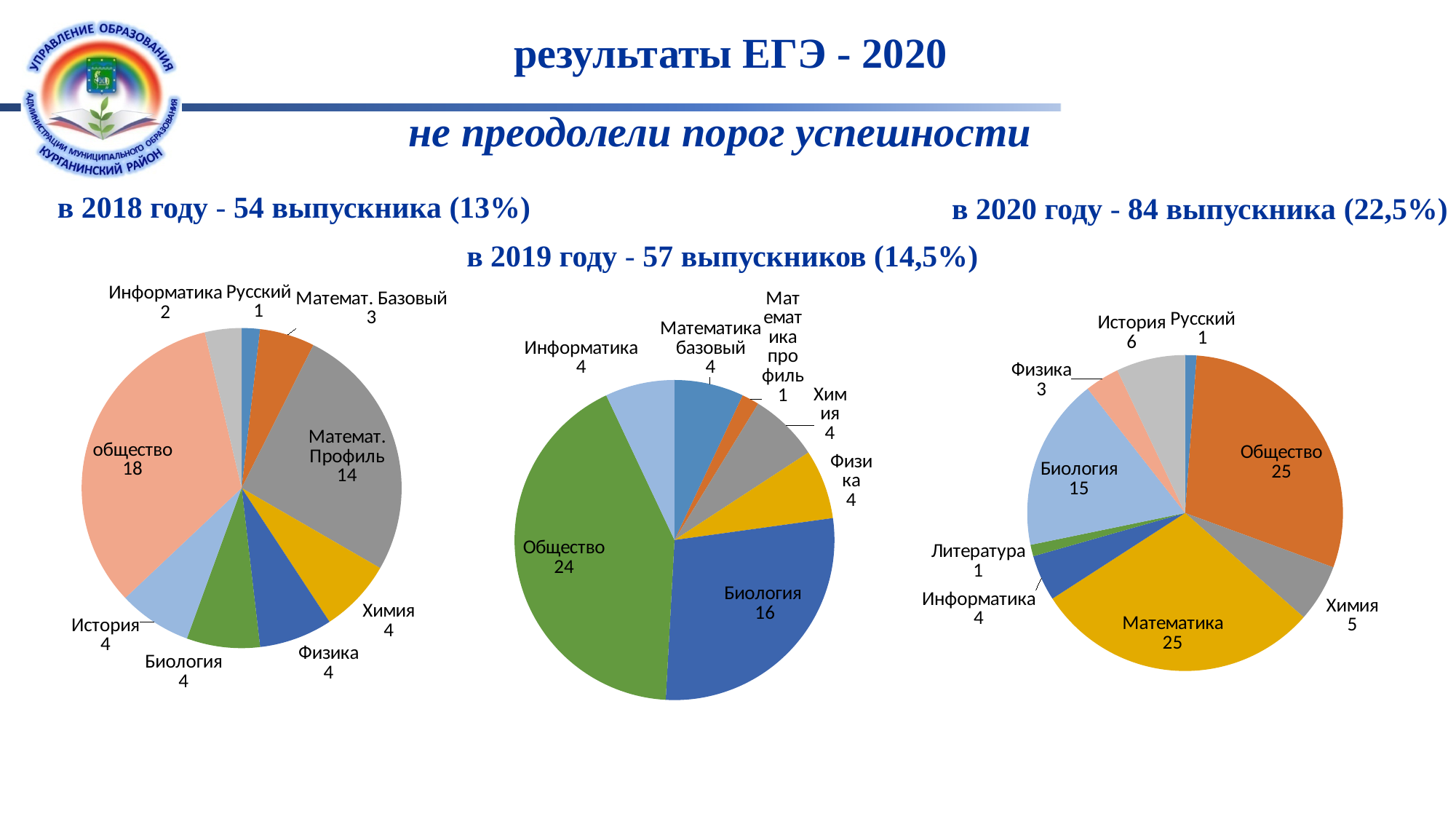
In the right pie chart, what is the value for Биология? 15 In the middle pie chart, what is the difference between Общество and Биология? 8 In the middle pie chart, how many categories are shown? 7 In the right pie chart, which is larger, История or Химия? История In the left pie chart, which category has the largest slice? общество In the left pie chart, which category has the smallest slice? Русский In the middle pie chart, what is the value for Биология? 16 What kind of charts are shown on the slide? Pie charts In the left pie chart, what is the value for общество? 18 In the left pie chart, how many categories are shown? 9 In the left pie chart, what is the value for Математ. Профиль? 14 In the middle pie chart, which category has the largest slice? Общество